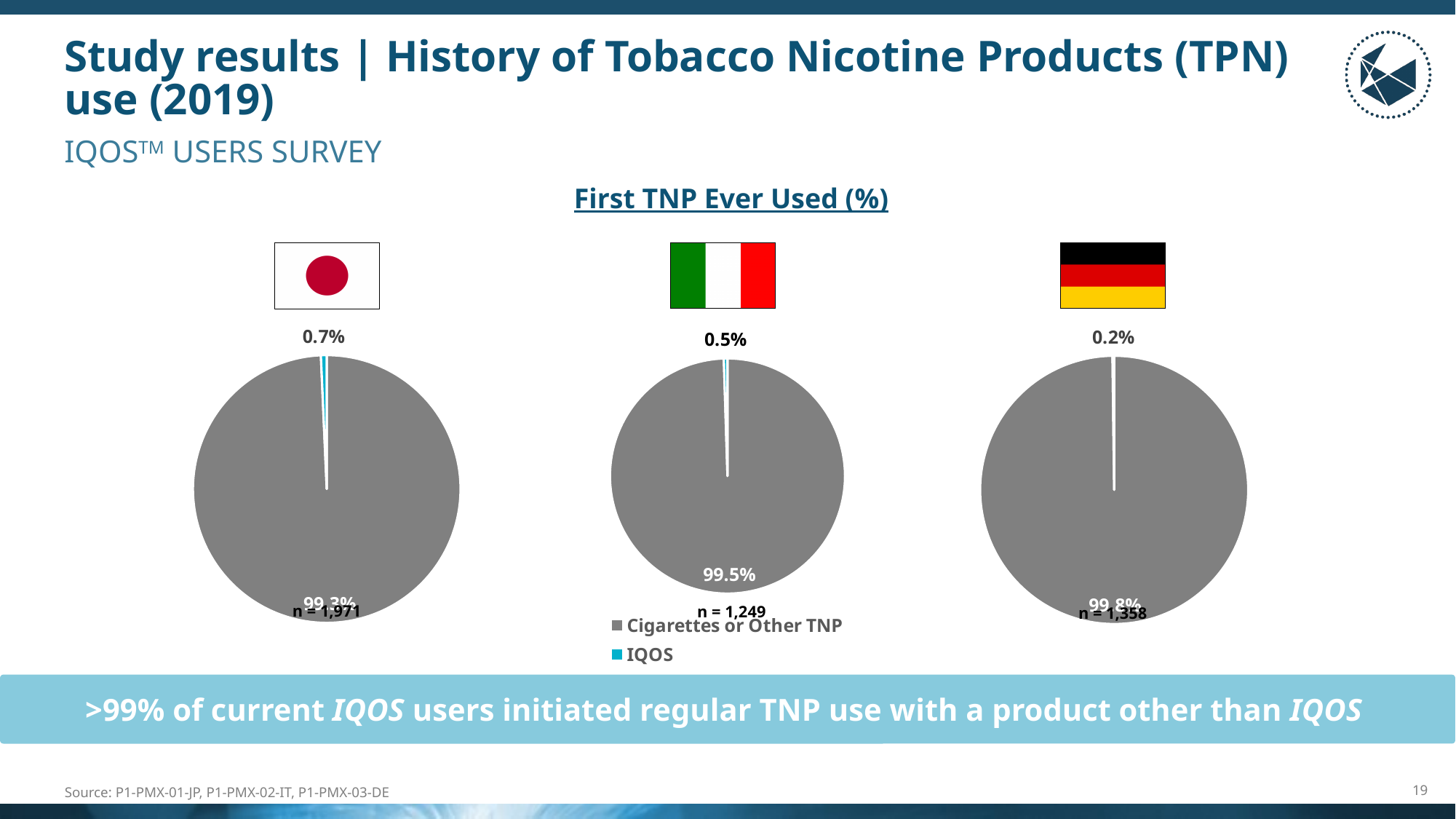
Is the IQOS share larger in the middle pie chart (Italy) or the right pie chart (Germany)? The middle pie chart (Italy) In the left pie chart (Japan flag), what share of respondents first used Cigarettes or Other TNP? 99.3% Which of the three pie charts shows the lowest IQOS share? The right pie chart (Germany) In the left pie chart (Japan flag), what share of respondents first used IQOS? 0.7% What is the difference between the IQOS share in the left pie chart (Japan) and the right pie chart (Germany)? 0.5% In the right pie chart (Germany flag), what share of respondents first used IQOS? 0.2% In the middle pie chart (Italy flag), what share of respondents first used Cigarettes or Other TNP? 99.5% What type of chart is used to show the first TNP ever used for each country? Pie chart What is the title shown above the three pie charts? First TNP Ever Used (%) What is the sample size (n) shown under the middle pie chart (Italy flag)? n = 1,249 How many series does the legend list? 2 Which of the three pie charts shows the highest IQOS share? The left pie chart (Japan)